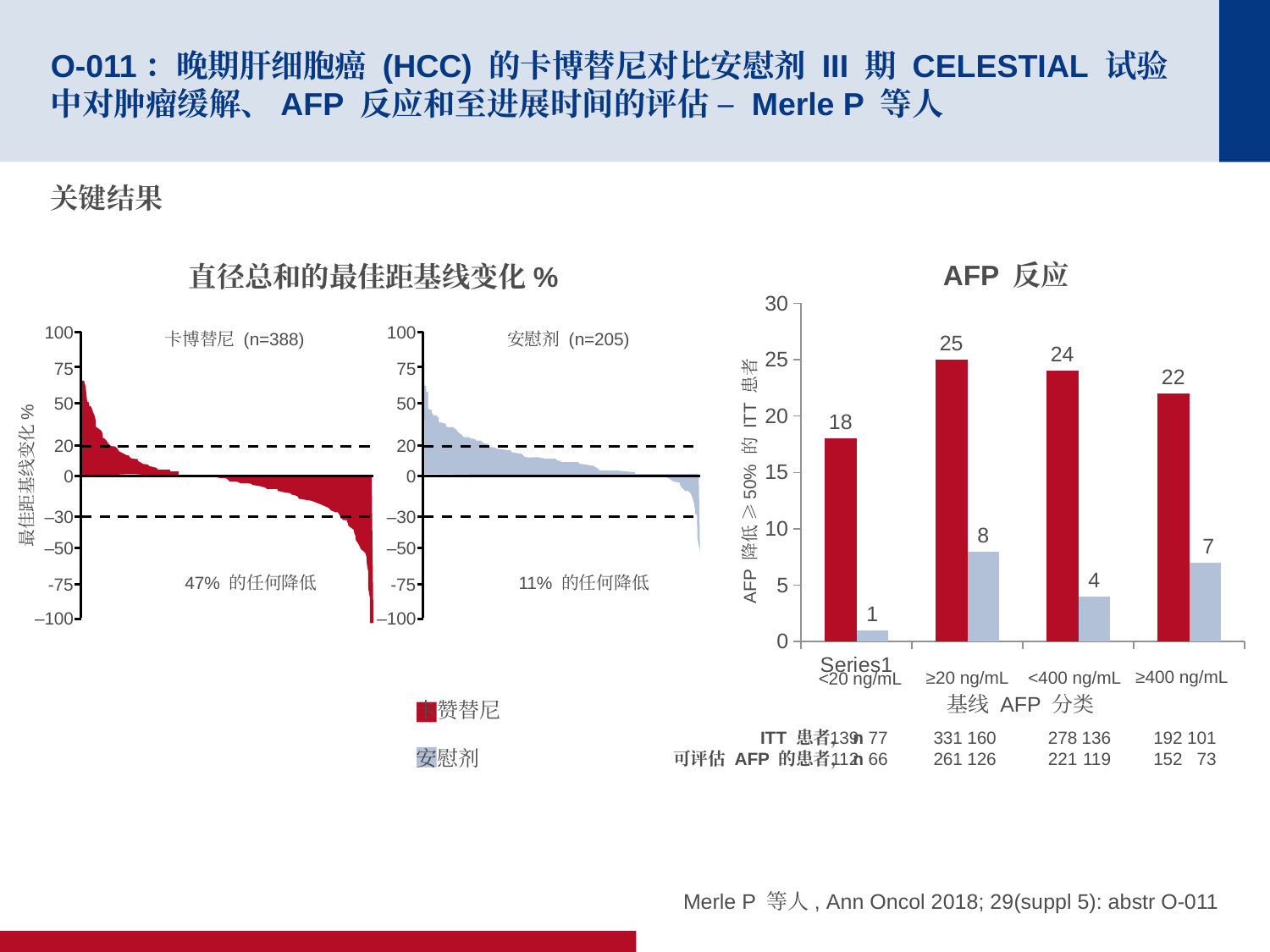
In the AFP 反应 chart, what is the value of the red bar for the <20 ng/mL category? 18 In the AFP 反应 chart, is the red bar for the <20 ng/mL category greater or less than 15? greater In the AFP 反应 chart, which baseline AFP category has the lowest blue bar? <20 ng/mL In the AFP 反应 chart, which is larger for the ≥400 ng/mL category, the red bar or the blue bar? the red bar In the left waterfall chart 直径总和的最佳距基线变化 %, what is the n for the 卡博替尼 panel? 388 How many baseline AFP categories are shown on the x axis of the AFP 反应 chart? 4 In the left waterfall chart 直径总和的最佳距基线变化 %, what percentage of patients had any reduction in the 安慰剂 panel? 11% In the AFP 反应 chart, what is the value of the blue bar for the ≥20 ng/mL category? 8 In the AFP 反应 chart, what is the value of the red bar for the ≥400 ng/mL category? 22 What kind of chart is the AFP 反应 chart? bar chart In the AFP 反应 chart, what is the difference between the red and blue bars for the <400 ng/mL category? 20 In the AFP 反应 chart, which baseline AFP category has the highest red bar? ≥20 ng/mL